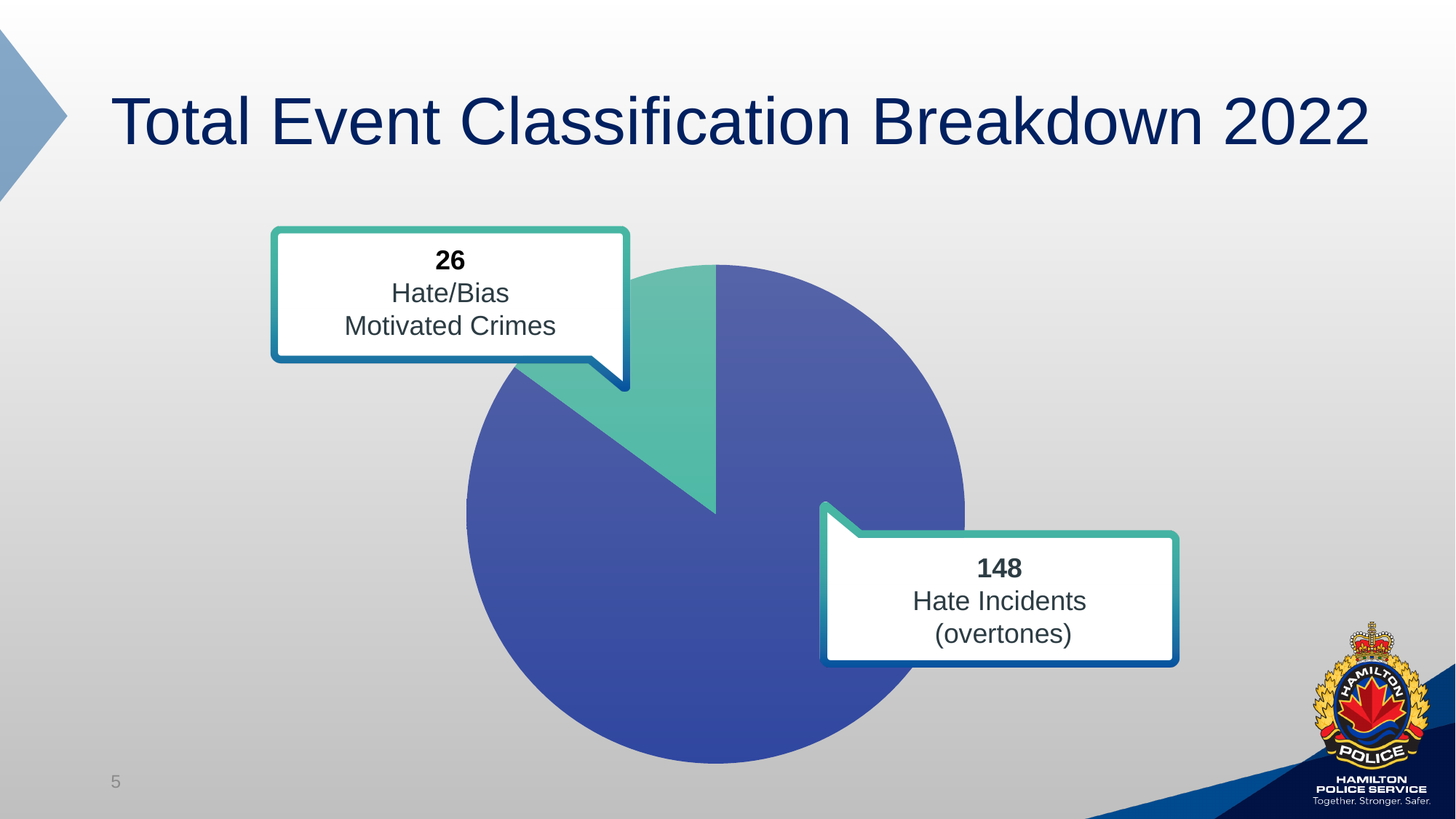
What is the value for Hate/Bias Motivated Crimes in the pie chart? 26 What colour is the slice for Hate Incidents (overtones)? Blue What is the value for Hate Incidents (overtones) in the pie chart? 148 Which category has the smallest slice of the pie chart? Hate/Bias Motivated Crimes Which is larger: Hate/Bias Motivated Crimes or Hate Incidents (overtones)? Hate Incidents (overtones) What is the title of the slide containing the pie chart? Total Event Classification Breakdown 2022 What is the difference between the number of Hate Incidents (overtones) and the number of Hate/Bias Motivated Crimes? 122 Which category has the largest slice of the pie chart? Hate Incidents (overtones) What kind of chart is shown on the slide? Pie chart What is the total of all events shown in the pie chart? 174 How many categories are shown in the pie chart? 2